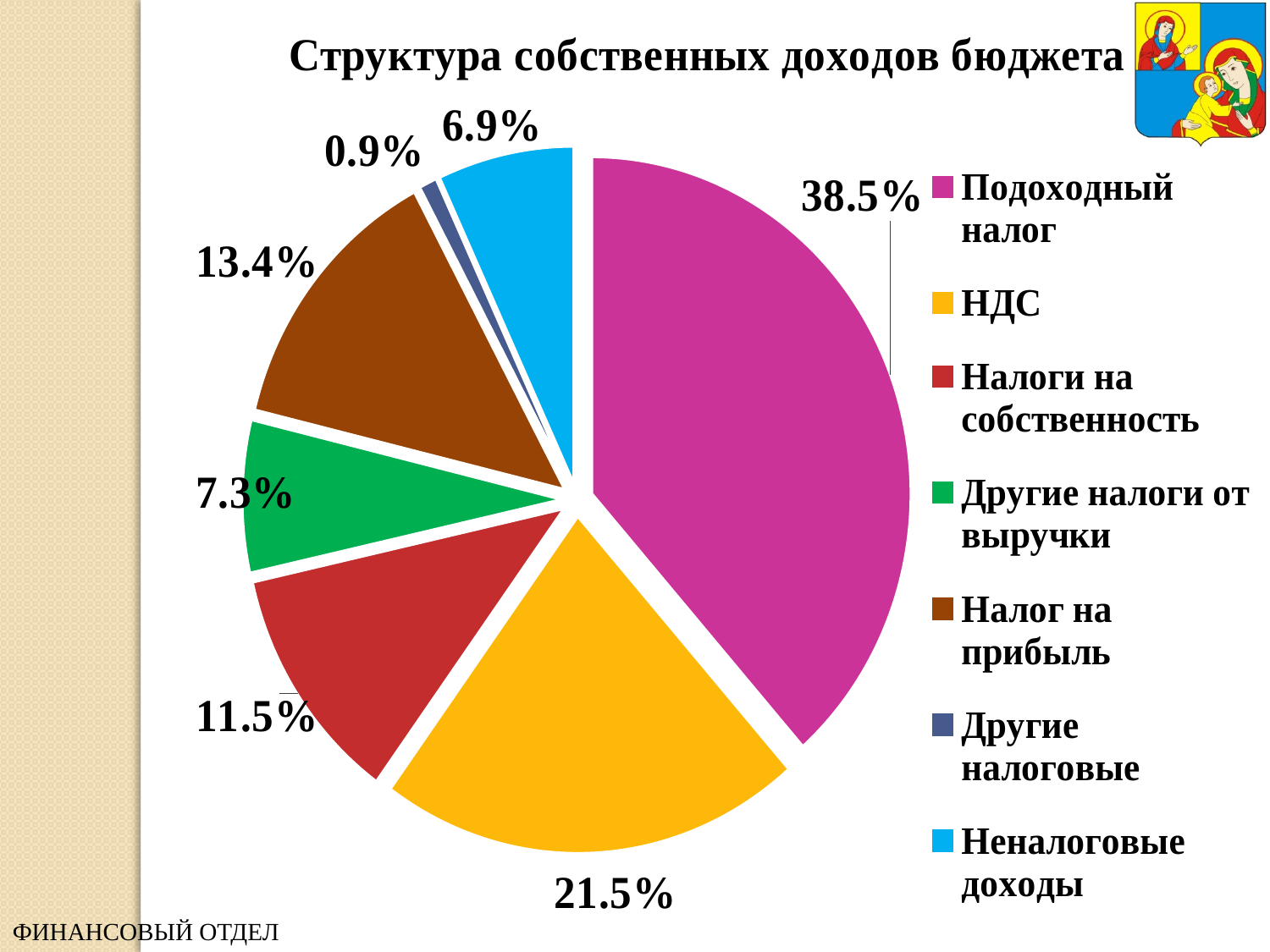
Which is larger, Налоги на собственность or Налог на прибыль? Налог на прибыль What share of the pie is Подоходный налог? 38.5% What kind of chart is shown on the slide? Pie chart How many slices does the pie chart have? 7 What is the value shown for Неналоговые доходы? 6.9% What is the value shown for Налог на прибыль? 13.4% What is the difference between the shares of Подоходный налог and НДС? 17.0% Which category has the smallest share of the pie? Другие налоговые What is the title of the chart? Структура собственных доходов бюджета What is the value shown for НДС? 21.5% What colour is the slice for Другие налоги от выручки? Green Which category has the largest share of the pie? Подоходный налог